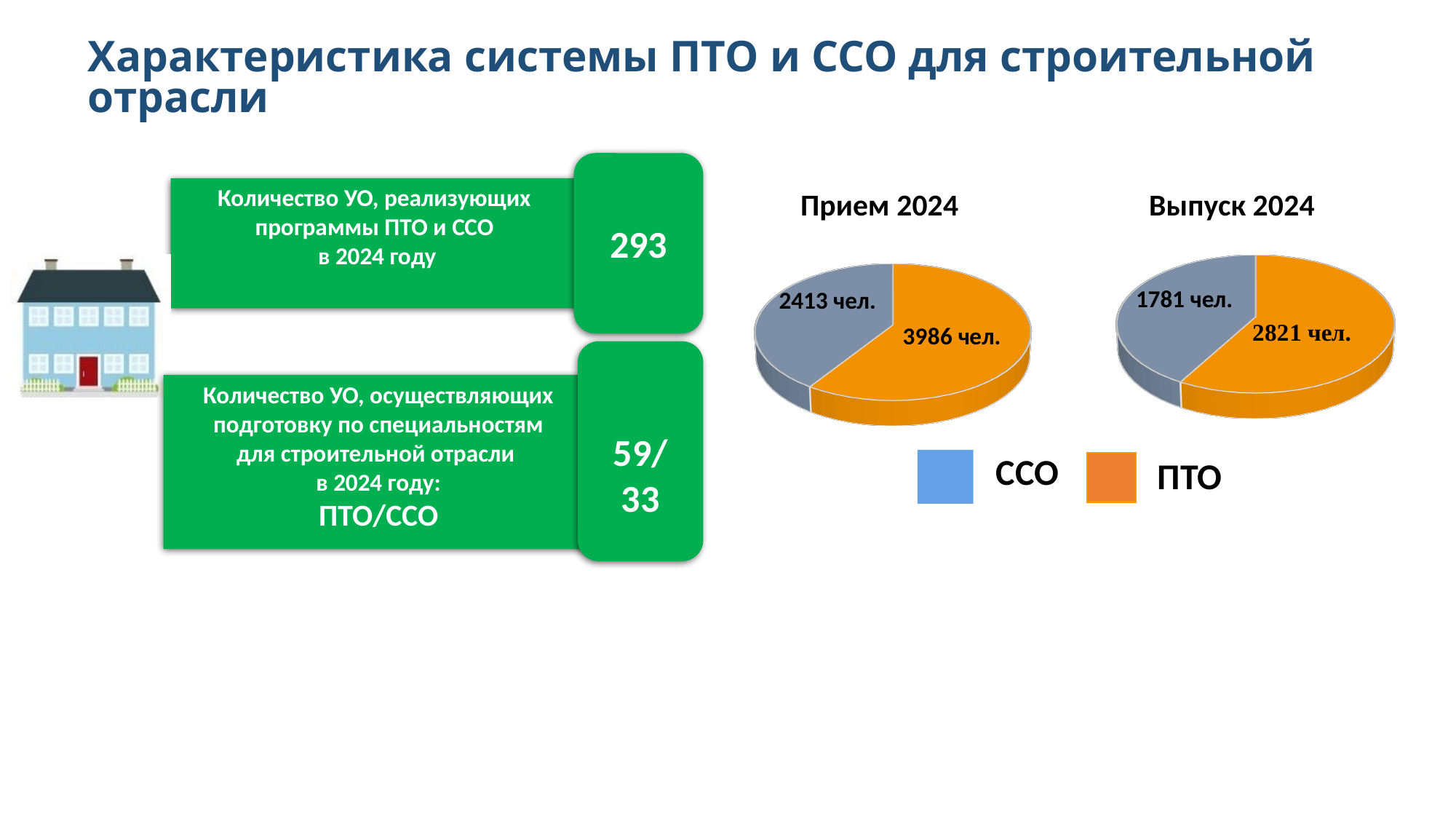
In the "Выпуск 2024" chart, what is the value for ССО? 1781 чел. In the "Выпуск 2024" chart, what is the value for ПТО? 2821 чел. In the "Прием 2024" chart, what is the value for ССО? 2413 чел. In the legend for the pie charts, which category is shown in orange? ПТО In the "Прием 2024" chart, what is the difference between the ПТО and ССО values? 1573 чел. Is the ПТО value in the "Прием 2024" chart larger or smaller than the ПТО value in the "Выпуск 2024" chart? larger In the "Выпуск 2024" chart, what is the difference between the ПТО and ССО values? 1040 чел. What kind of chart is used for "Прием 2024"? pie chart How many categories does the legend list for the pie charts? 2 In the "Прием 2024" chart, what is the value for ПТО? 3986 чел. In the "Прием 2024" chart, which category has the largest slice? ПТО In the "Выпуск 2024" chart, which category has the smallest slice? ССО